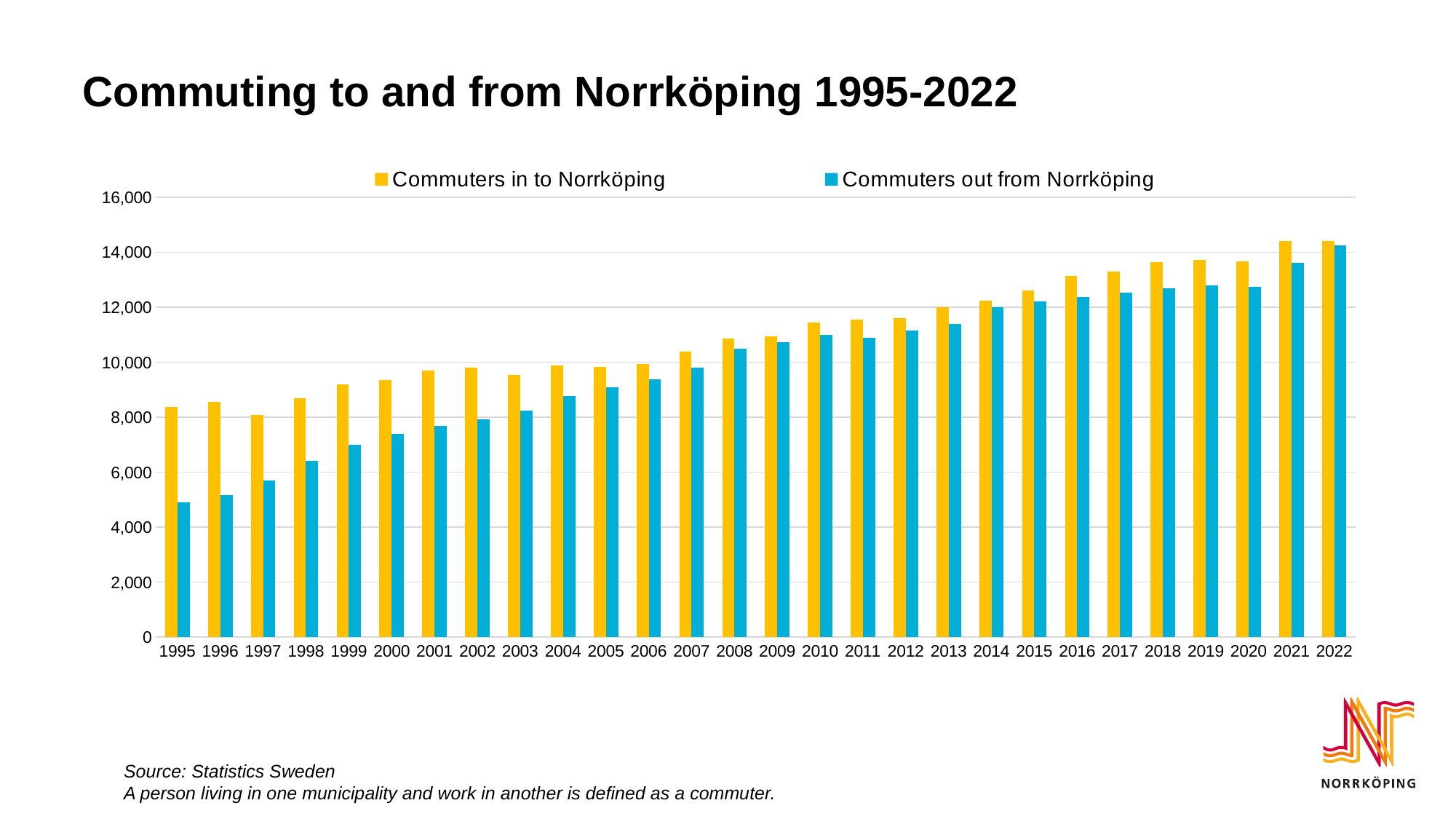
In 1999, which is larger: Commuters in to Norrköping or Commuters out from Norrköping? Commuters in to Norrköping Is the value for Commuters out from Norrköping in 2000 greater or less than 8,000? less Is the value for Commuters in to Norrköping in 1995 greater or less than 8,000? greater Is the value for Commuters out from Norrköping in 1995 greater or less than 6,000? less How many years are shown on the x axis? 28 What kind of chart is shown on the slide? bar chart Do the values for Commuters out from Norrköping generally rise or fall from 1995 to 2022? rise How many series does the legend list? 2 What colour are the bars for Commuters out from Norrköping? blue Which year has the highest value for Commuters out from Norrköping? 2022 Which year has the lowest value for Commuters out from Norrköping? 1995